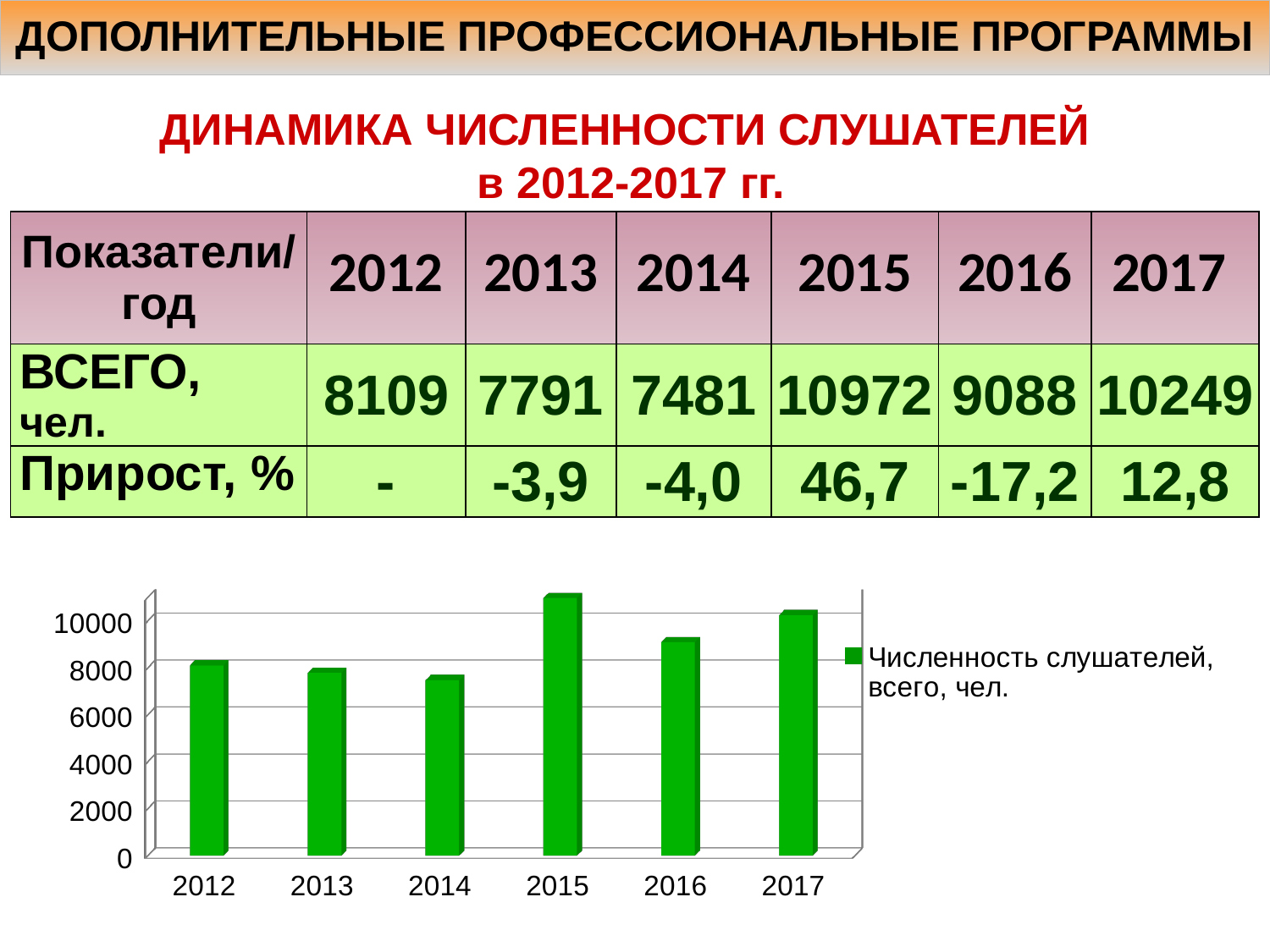
How many series does the chart legend list? 1 Which year has the highest number of listeners in the chart? 2015 Which year has the lowest number of listeners in the chart? 2014 What kind of chart is shown on the slide? bar chart Is the value for 2016 greater or less than 8000? greater What is the number of listeners for 2012? 8109 What is the difference between the values for 2015 and 2014? 3491 Which is larger, the value for 2017 or the value for 2016? 2017 Is the value for 2014 greater or less than 8000? less What is the legend entry of the chart? Численность слушателей, всего, чел. What is the number of listeners for 2015? 10972 How many years (categories) are shown on the x axis of the chart? 6